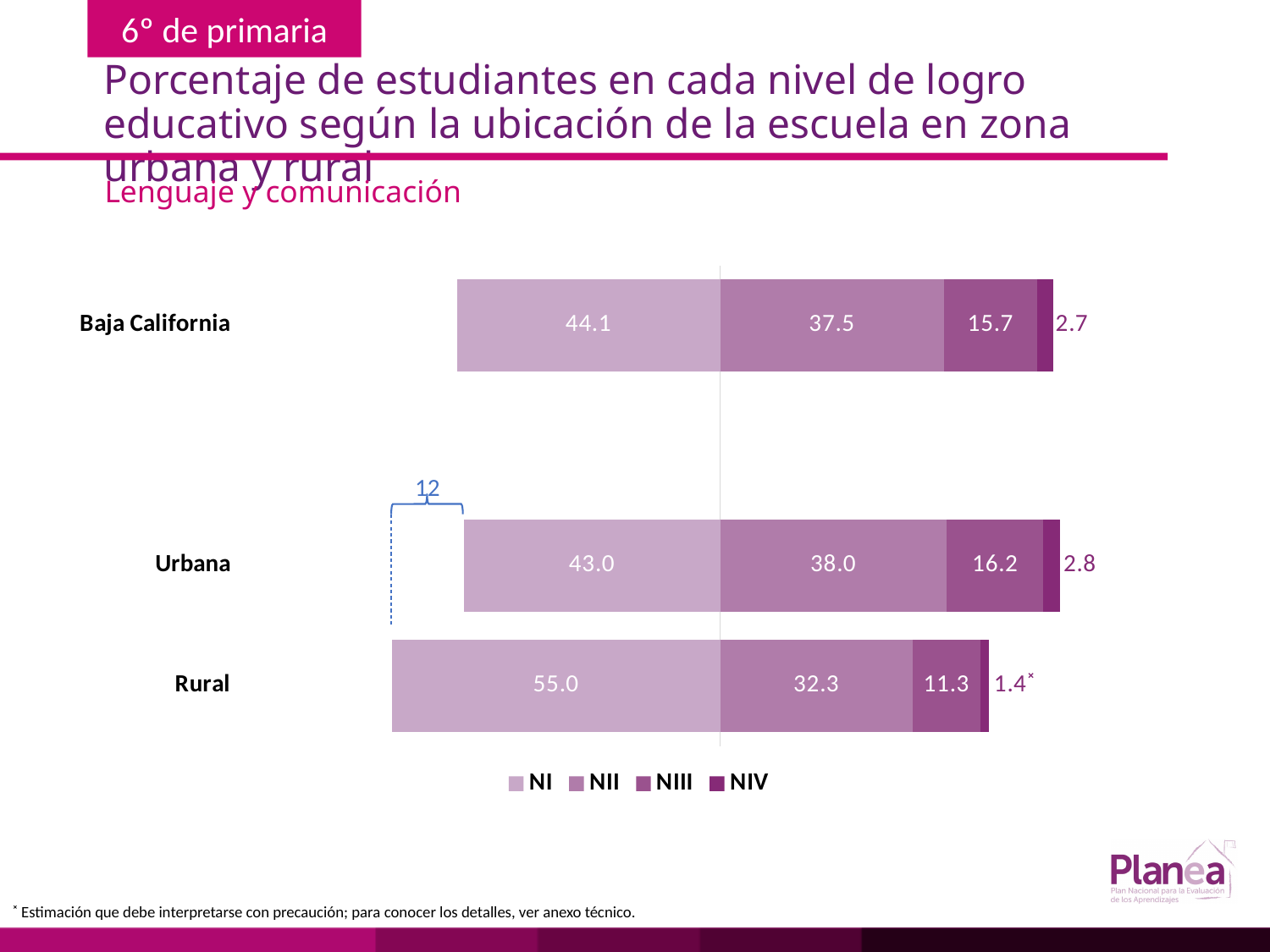
Which is larger, the NII value for Baja California or the NII value for Rural? Baja California Which category has the lowest NIII value? Rural How many categories (bars) are plotted in the chart? 3 Which category has the highest NI value? Rural What is the NIV value for Rural? 1.4 What is the difference between the NI values for Rural and Urbana? 12.0 What is the NII value for Urbana? 38.0 What is the NI value for Rural? 55.0 How many series does the legend list? 4 What is the NIII value for Baja California? 15.7 What kind of chart is shown on the slide? Stacked bar chart What is the total of the stacked bar for Urbana? 100.0